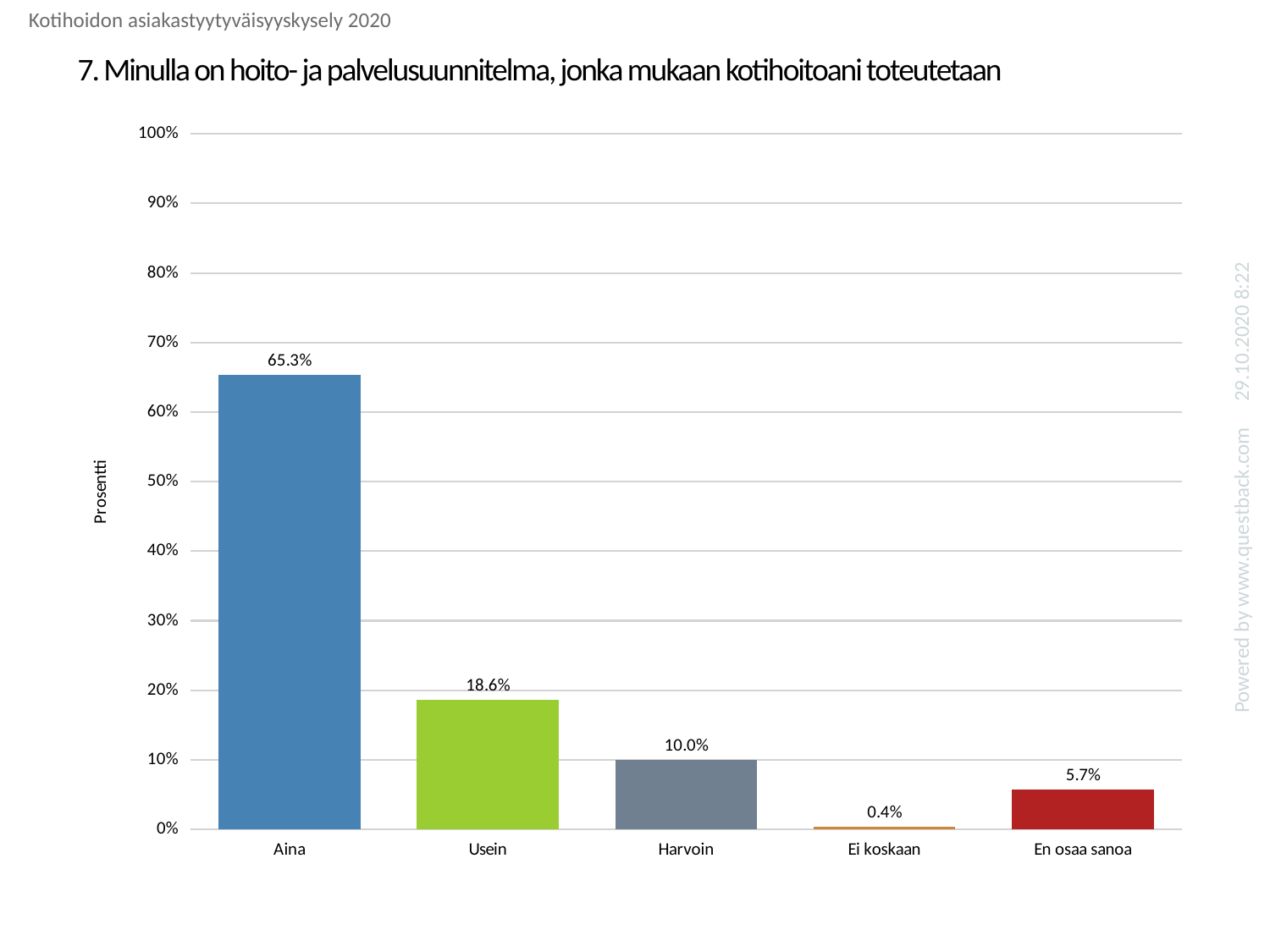
Which category has the highest value? Aina How many categories are shown on the x axis? 5 What kind of chart is shown on the slide? bar chart What is the value for Usein? 18.6% What is the value for Ei koskaan? 0.4% What is the value for Aina? 65.3% What is the value for En osaa sanoa? 5.7% What is the label of the y axis? Prosentti Which category has the lowest value? Ei koskaan Is the value for Usein greater or less than 20%? less What is the difference between the values for Aina and Usein? 46.7% Which is larger, the value for Harvoin or the value for En osaa sanoa? Harvoin